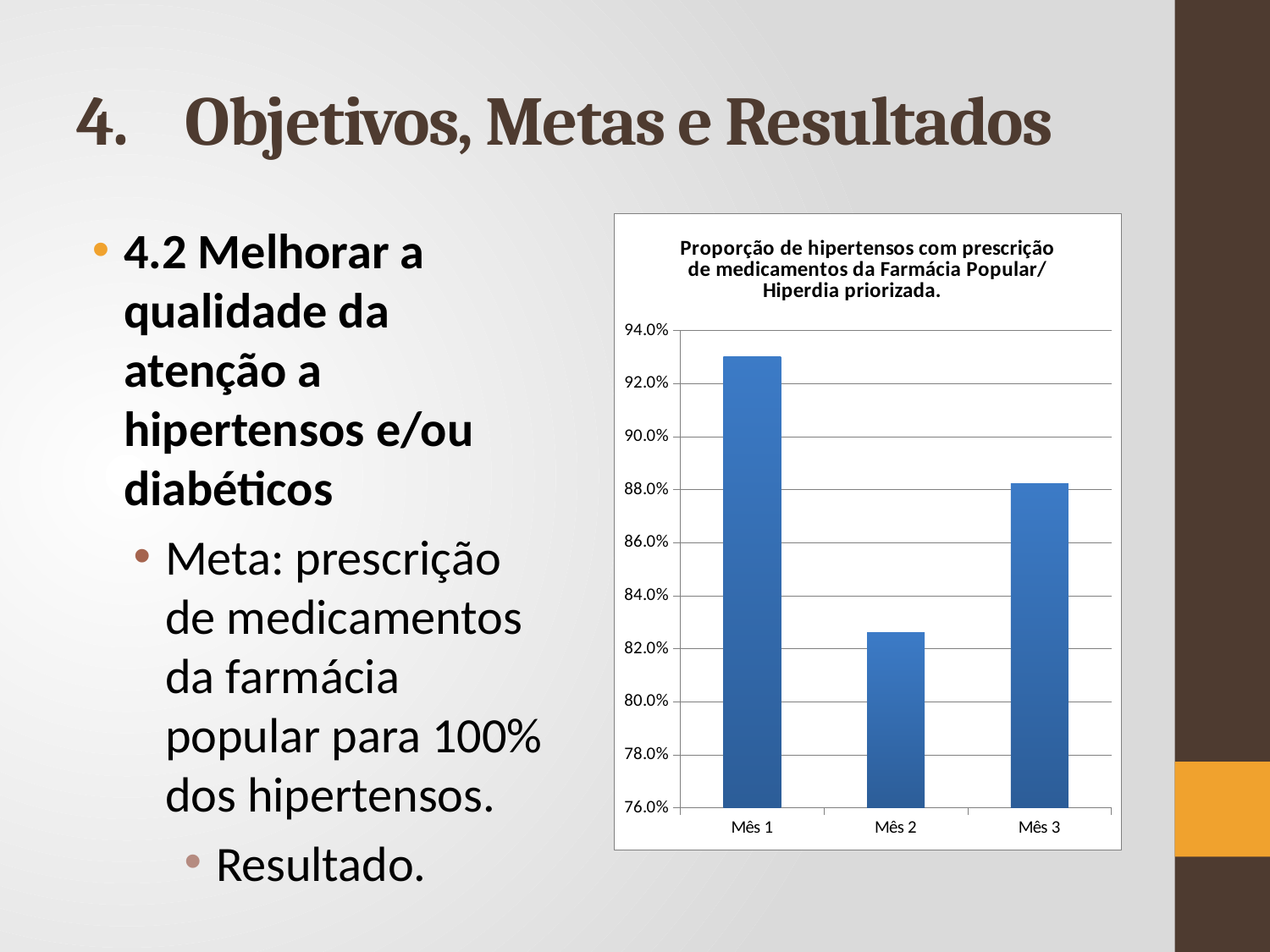
Which month has the highest value in the chart? Mês 1 Which month has the lowest value in the chart? Mês 2 Is the value for Mês 3 greater or less than 90.0%? less What is the title of the chart? Proporção de hipertensos com prescrição de medicamentos da Farmácia Popular/Hiperdia priorizada. What is the highest value shown on the y axis of the chart? 94.0% Is the value for Mês 2 greater or less than 84.0%? less Is the value for Mês 1 greater or less than 92.0%? greater What kind of chart is shown on the slide? bar chart Which is larger, the value for Mês 1 or the value for Mês 3? Mês 1 Does the value fall or rise from Mês 1 to Mês 2? fall Which is larger, the value for Mês 2 or the value for Mês 3? Mês 3 How many categories are shown on the x axis of the chart? 3